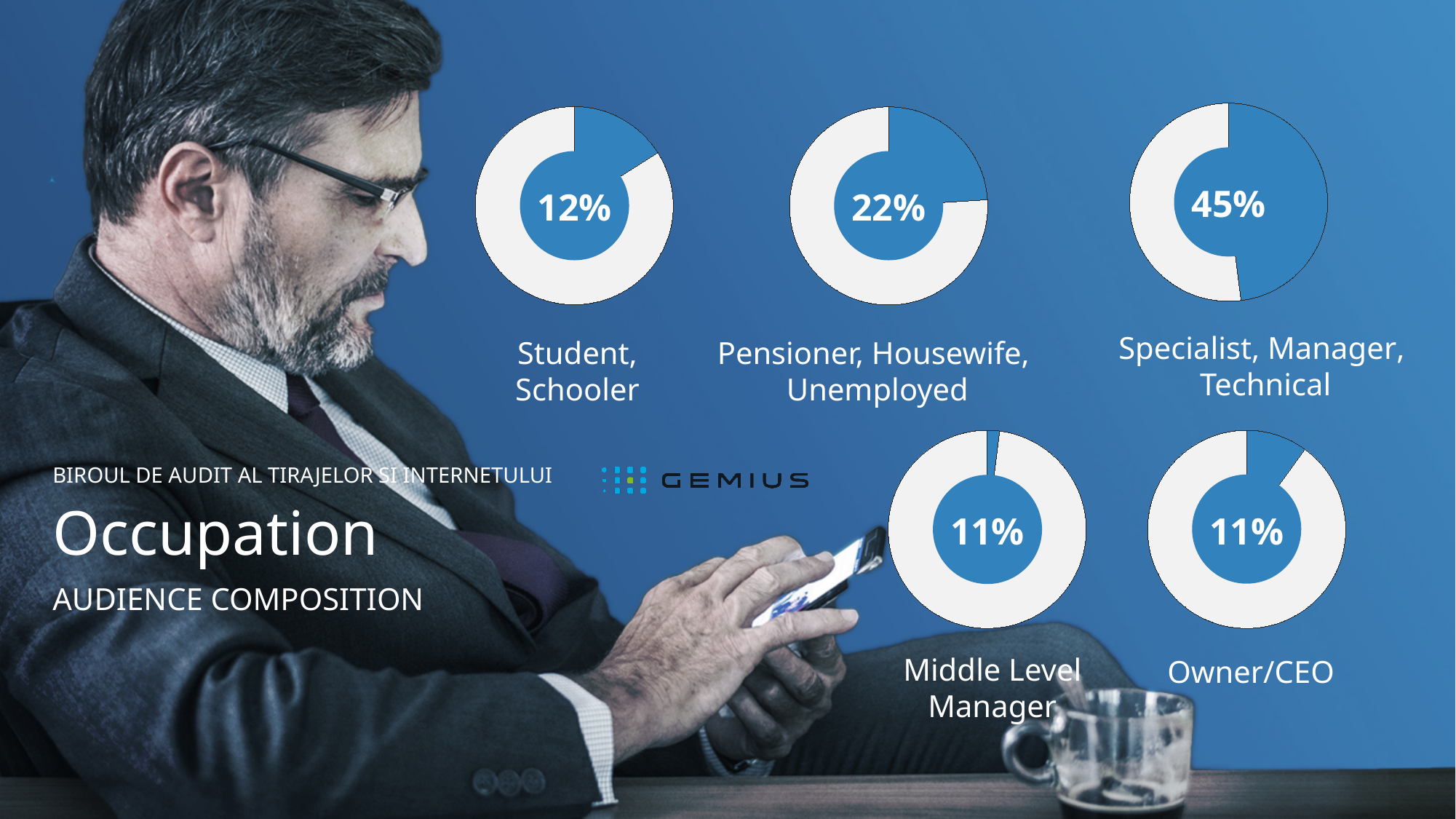
What percentage is shown in the donut chart labelled Owner/CEO? 11% What percentage is shown in the donut chart labelled Student, Schooler? 12% Across the five donut charts on the slide, which occupation group has the highest percentage? Specialist, Manager, Technical What is the difference between the percentage in the Specialist, Manager, Technical chart and the percentage in the Pensioner, Housewife, Unemployed chart? 23% What is the difference between the percentage in the Pensioner, Housewife, Unemployed chart and the percentage in the Student, Schooler chart? 10% What percentage is shown in the donut chart labelled Pensioner, Housewife, Unemployed? 22% What percentage is shown in the donut chart labelled Specialist, Manager, Technical? 45% Which is larger: the percentage in the Student, Schooler chart or the percentage in the Pensioner, Housewife, Unemployed chart? Pensioner, Housewife, Unemployed What percentage is shown in the donut chart labelled Middle Level Manager? 11% What kind of chart is used to show the Owner/CEO percentage? Donut chart How many donut charts are shown on the slide? 5 What is the main title of the slide containing the donut charts? Occupation